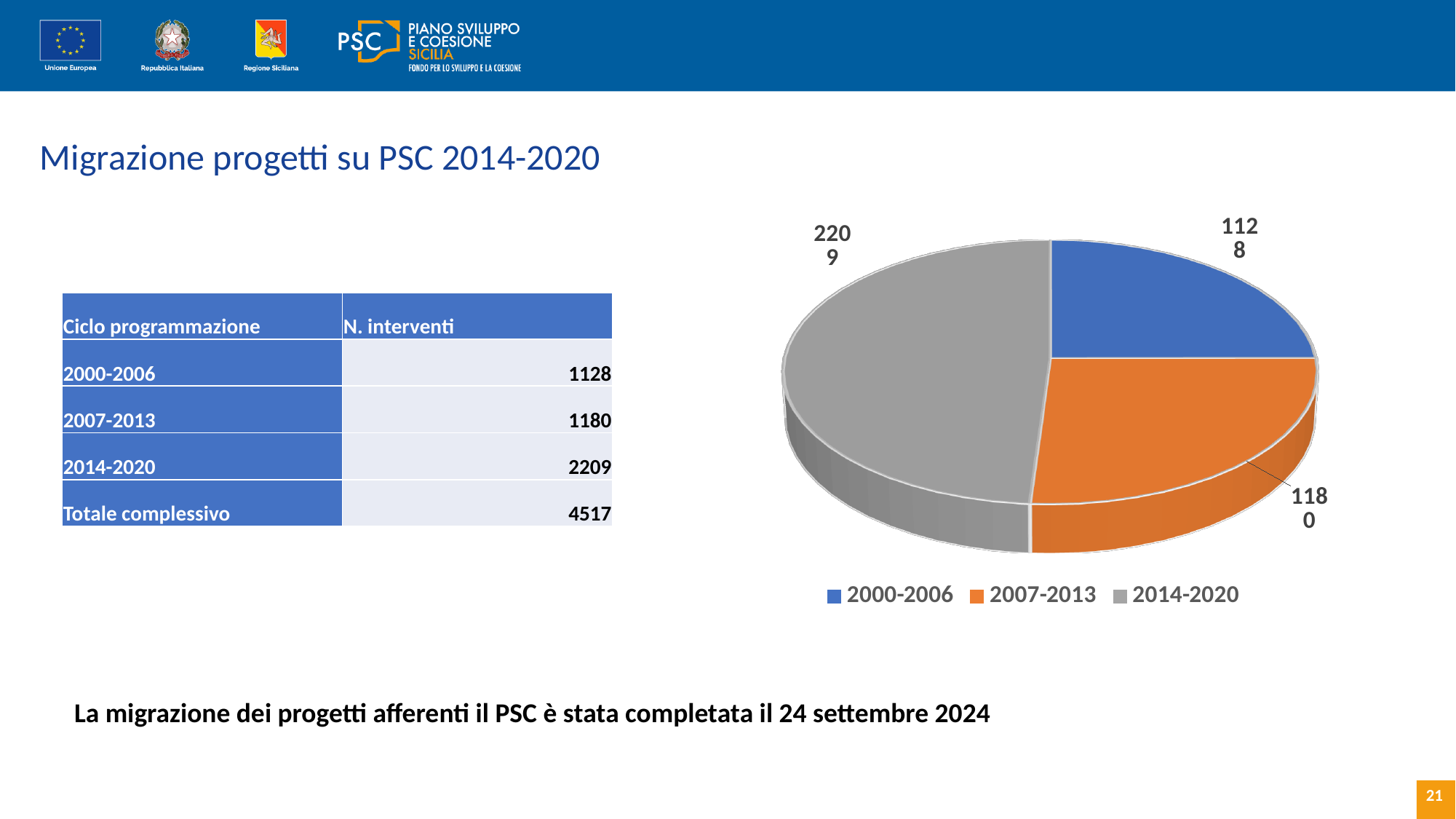
Which programming cycle has the smallest slice in the pie chart? 2000-2006 What is the total of all three slices in the pie chart? 4517 What kind of chart is shown on the slide? pie chart What is the difference between the 2014-2020 slice and the 2007-2013 slice in the pie chart? 1029 What is the value of the 2007-2013 slice in the pie chart? 1180 Which programming cycle has the largest slice in the pie chart? 2014-2020 Which colour represents 2014-2020 in the pie chart? grey How many entries does the pie chart's legend list? 3 How many slices does the pie chart have? 3 In the pie chart, which is larger: the 2007-2013 slice or the 2000-2006 slice? 2007-2013 What is the value of the 2014-2020 slice in the pie chart? 2209 What is the value of the 2000-2006 slice in the pie chart? 1128